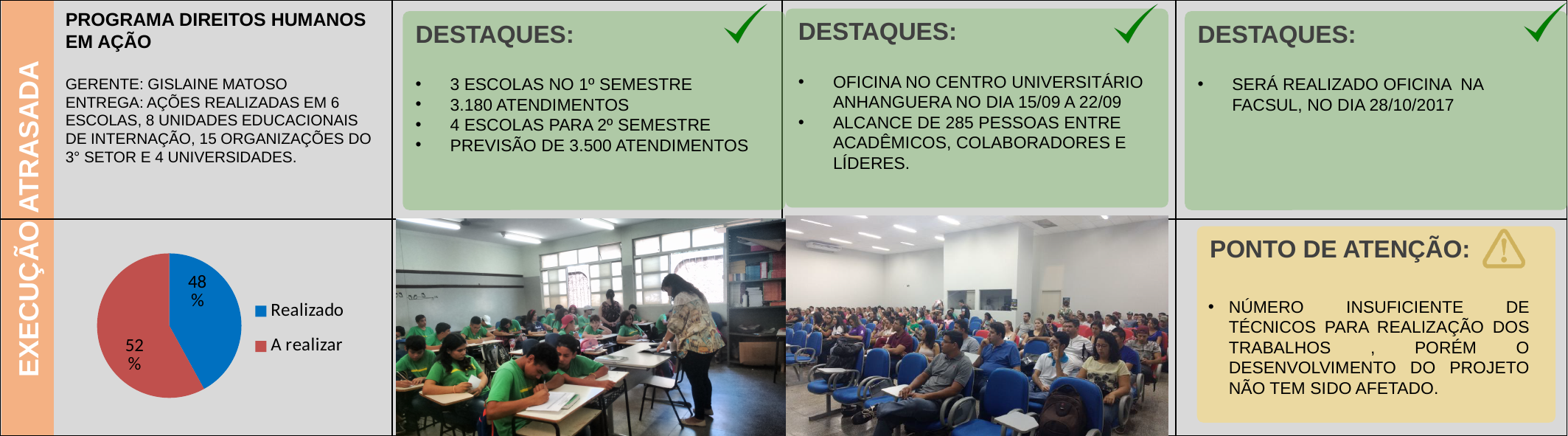
What colour is the "Realizado" slice in the pie chart? blue Which category has the smallest share of the pie chart? Realizado What percentage of the pie chart is labelled "Realizado"? 48% How many entries does the pie chart legend list? 2 Which slice of the pie chart is larger, "Realizado" or "A realizar"? A realizar Which category has the largest share of the pie chart? A realizar What colour is the "A realizar" slice in the pie chart? red How many slices does the pie chart have? 2 What percentage of the pie chart is labelled "A realizar"? 52% Is the share for "Realizado" greater or less than 50%? less What is the difference in percentage points between the "A realizar" and "Realizado" slices? 4 What kind of chart is shown on the slide? pie chart